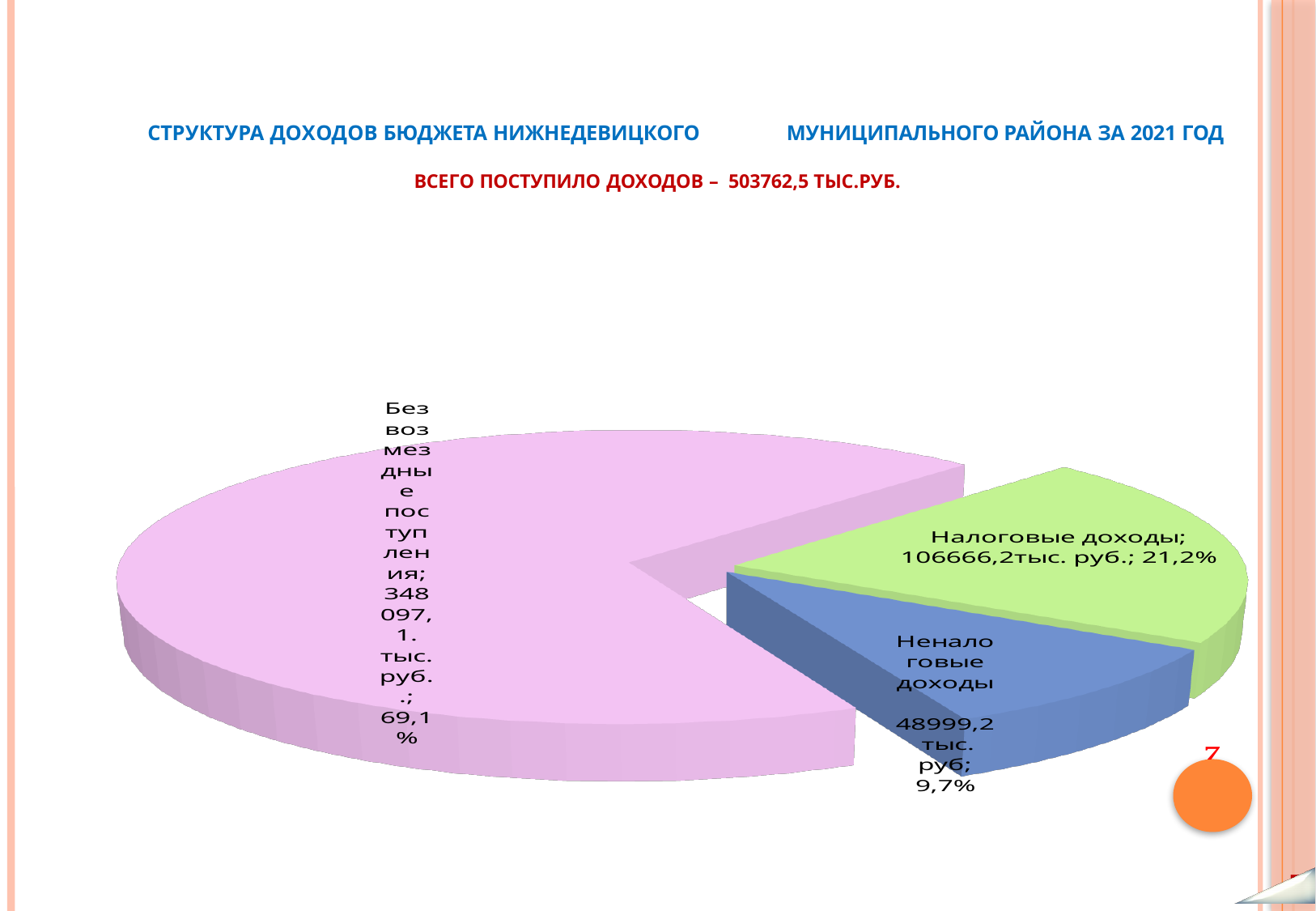
What percentage share does the slice 'Неналоговые доходы' have? 9,7% What value in тыс. руб. is shown for 'Безвозмездные поступления'? 348097,1 тыс. руб. What percentage share does the slice 'Налоговые доходы' have? 21,2% By how many percentage points does the share of 'Налоговые доходы' exceed the share of 'Неналоговые доходы'? 11,5% What value in тыс. руб. is shown for 'Налоговые доходы'? 106666,2 тыс. руб. Which slice of the pie chart is the smallest? Неналоговые доходы What colour is the slice for 'Налоговые доходы'? green How many slices does the pie chart have? 3 What kind of chart is shown on the slide? pie chart What percentage share does the slice 'Безвозмездные поступления' have? 69,1% Which slice of the pie chart is the largest? Безвозмездные поступления What value in тыс. руб. is shown for 'Неналоговые доходы'? 48999,2 тыс. руб.